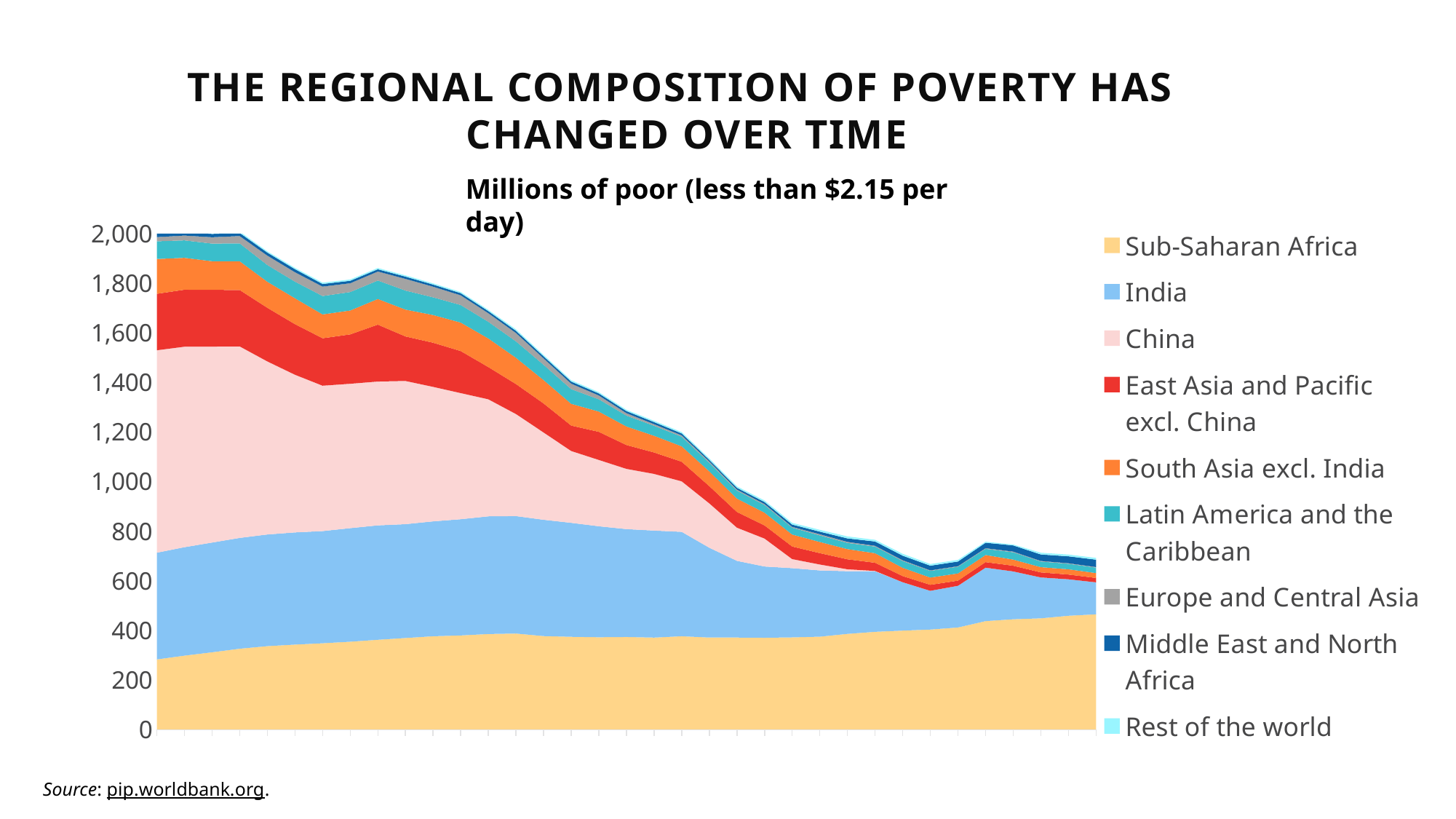
Is the total number of poor at the right edge of the chart greater or less than 800? less At the right edge of the chart, which band is thicker: Sub-Saharan Africa or India? Sub-Saharan Africa Does the Sub-Saharan Africa band rise or fall from the left of the chart to the right? Rise Does the total number of poor rise or fall from the left of the chart to the right? Fall What unit does the chart subtitle say the values are in? Millions of poor (less than $2.15 per day) Is the value for Sub-Saharan Africa at the left edge of the chart greater or less than 400? less Is the value for Sub-Saharan Africa at the right edge of the chart greater or less than 400? greater At the left edge of the chart, which band is thicker: China or India? China How many series does the legend list? 9 What kind of chart is shown on the slide? Stacked area chart What is the title of the chart? THE REGIONAL COMPOSITION OF POVERTY HAS CHANGED OVER TIME